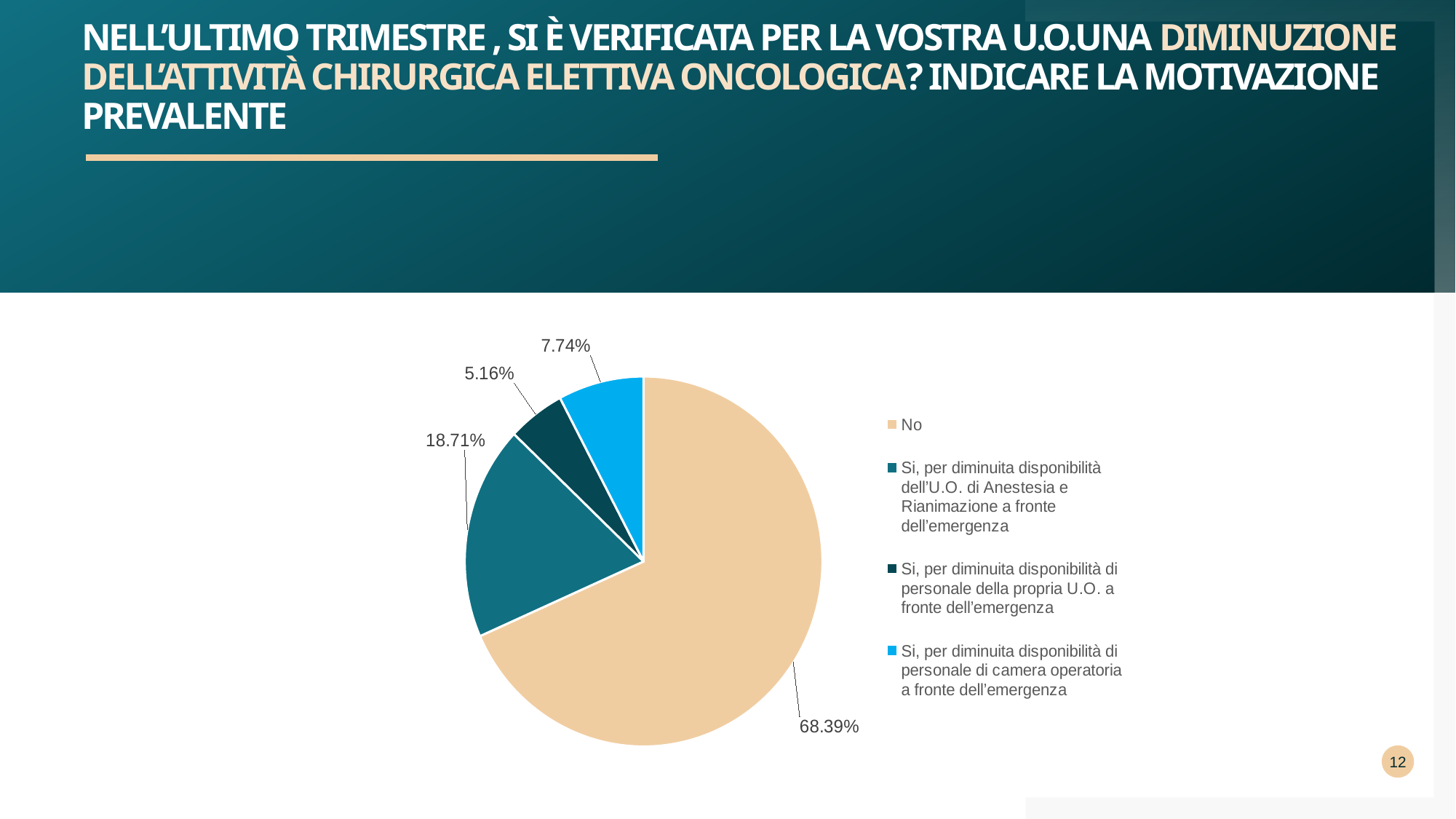
Which category has the largest slice of the pie? No What is the value for "Si, per diminuita disponibilità di personale di camera operatoria a fronte dell'emergenza"? 7.74% What share of the pie does the "No" slice represent? 68.39% Which is larger: the slice for diminished availability of camera operatoria staff or the slice for diminished availability of the U.O.'s own staff? Si, per diminuita disponibilità di personale di camera operatoria a fronte dell'emergenza What kind of chart is shown on the slide? Pie chart How many entries does the legend list? 4 Which category has the smallest slice of the pie? Si, per diminuita disponibilità di personale della propria U.O. a fronte dell'emergenza What is the value for "Si, per diminuita disponibilità dell'U.O. di Anestesia e Rianimazione a fronte dell'emergenza"? 18.71% What colour is the "No" slice in the pie chart? Tan (beige) What is the difference between the "No" slice and the "Si, per diminuita disponibilità dell'U.O. di Anestesia e Rianimazione a fronte dell'emergenza" slice? 49.68% How many slices does the pie chart have? 4 What is the value for "Si, per diminuita disponibilità di personale della propria U.O. a fronte dell'emergenza"? 5.16%